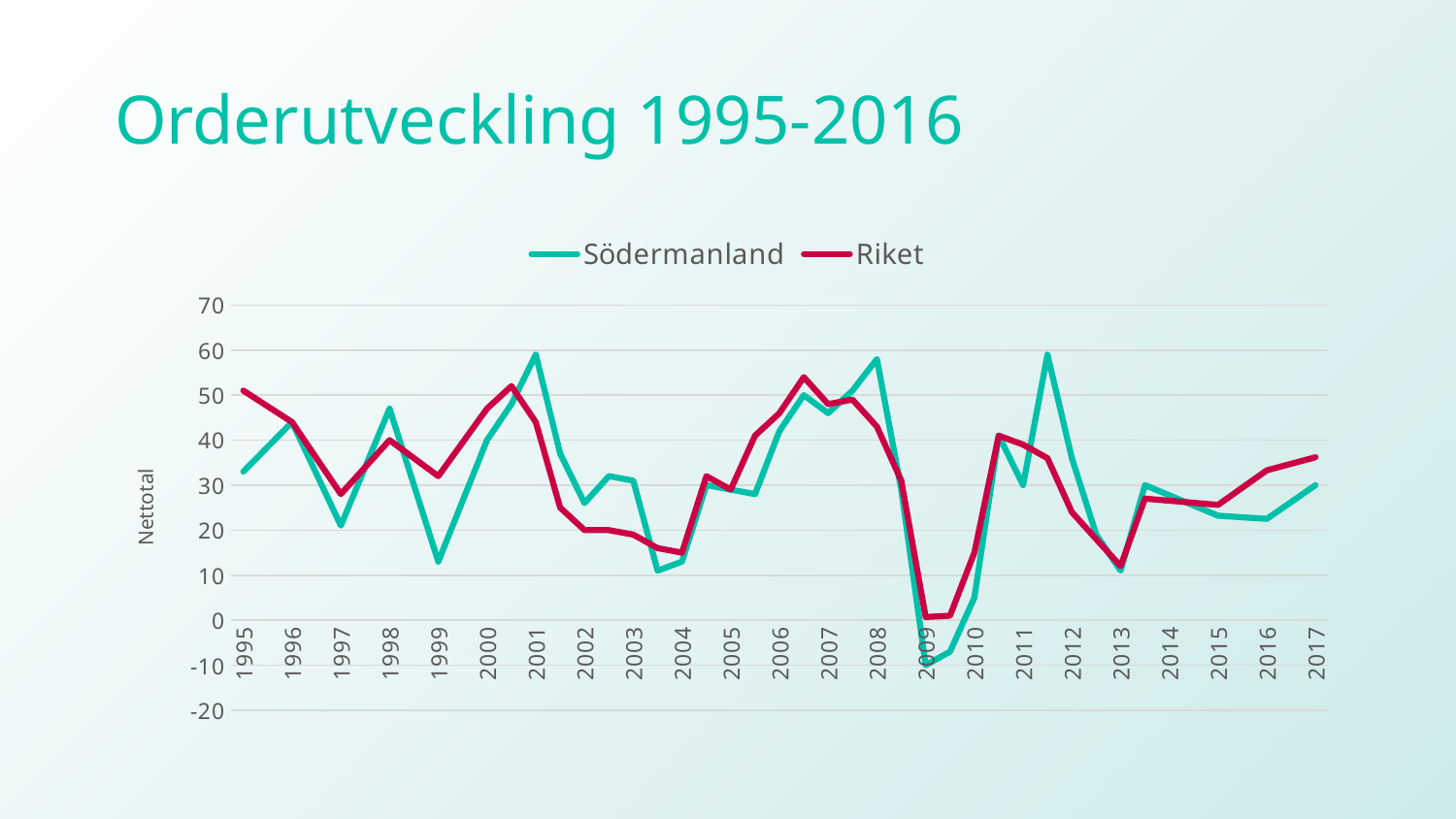
Is the value for Södermanland in 2009 greater or less than 0? less What kind of chart is shown on the slide? line chart Does the Riket series rise or fall from 2013 to 2017? rise In 1999, which series has the higher value, Södermanland or Riket? Riket Is the value for Riket in 2013 greater or less than 20? less How many series does the legend list? 2 What is the label on the vertical axis? Nettotal Is the value for Södermanland in 1999 greater or less than 20? less In which year does the Södermanland series reach its lowest value? 2009 What is the title of the chart? Orderutveckling 1995-2016